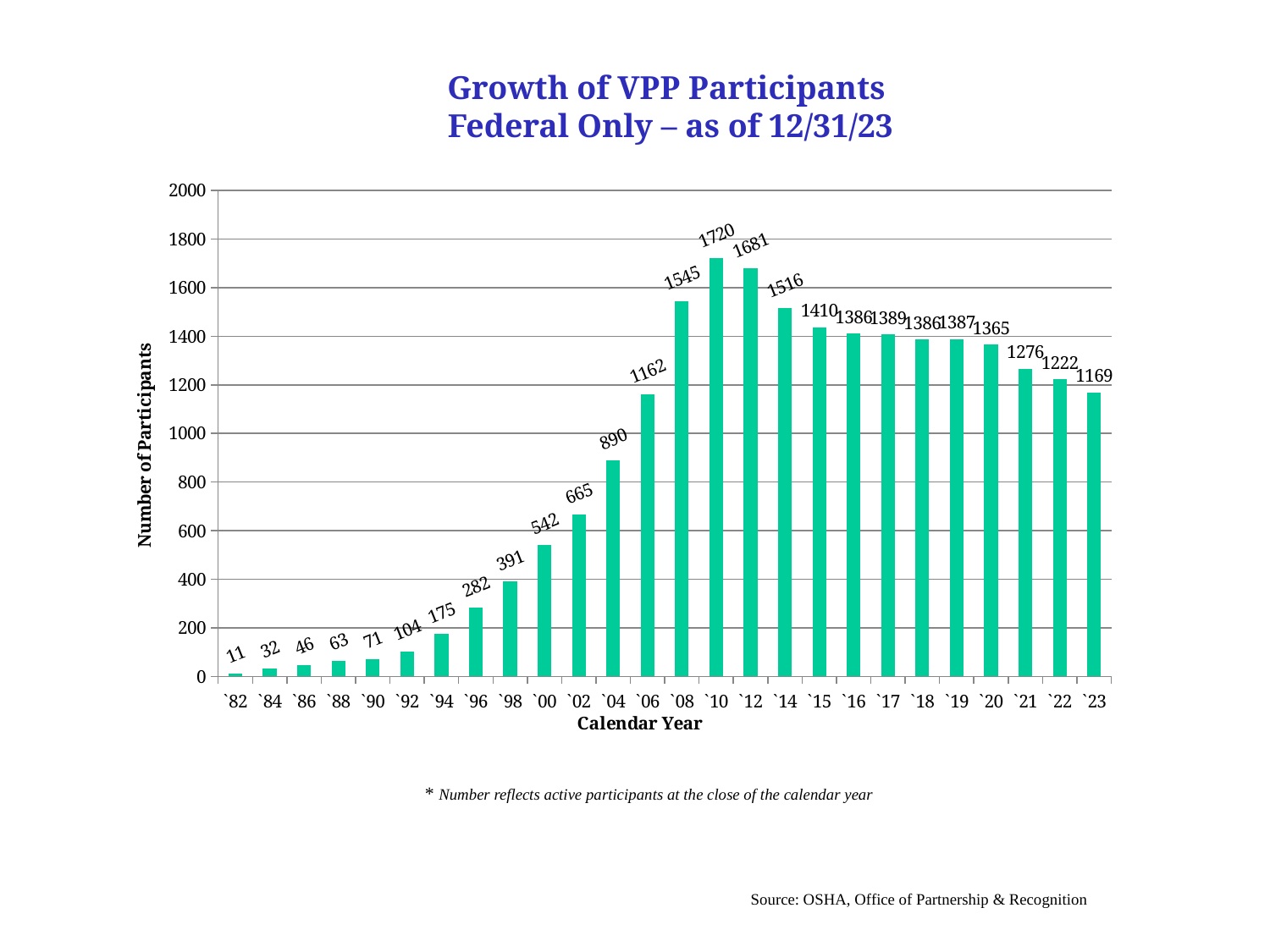
How many calendar years are shown on the x axis? 26 What is the difference in participants between `21 and `23? 107 Which calendar year has the lowest number of participants? `82 What is the number of participants for `94? 175 Which calendar year has the highest number of participants? `10 Is the value for `06 greater or less than 1000? greater Do the values rise or fall from `82 to `10? Rise What is the number of participants for `23? 1169 Which has more participants, `14 or `15? `14 What is the number of participants for `10? 1720 What kind of chart is shown on the slide? Bar chart What is the difference in participants between `10 and `12? 39